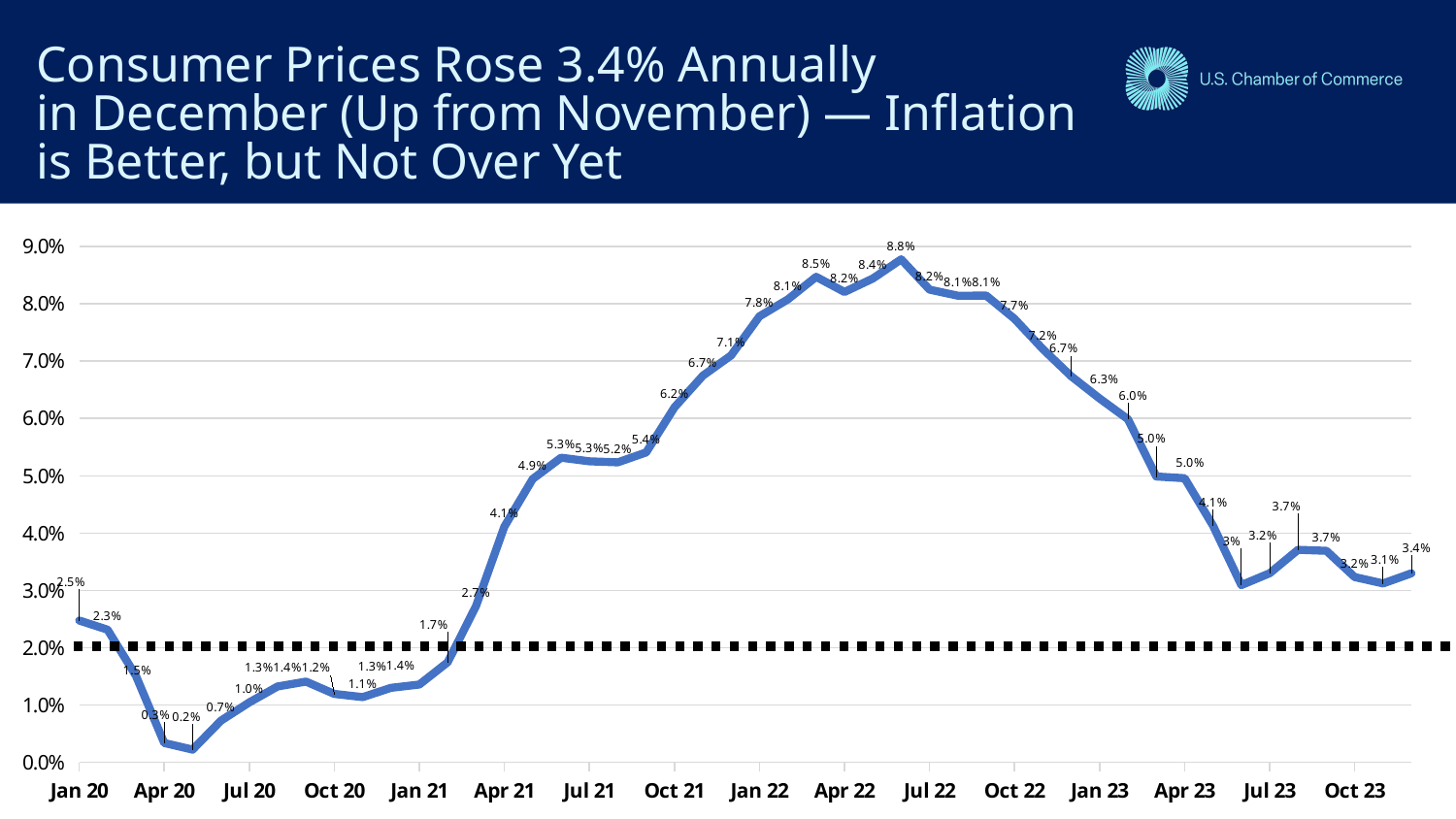
What is the value at Jan 20? 2.5% At what level is the horizontal dashed black line drawn? 2.0% What is the lowest value labeled on the line? 0.2% What is the value at Jan 23? 6.3% Does the line generally rise or fall between Jan 21 and Jul 22? rise Which is larger, the value at Apr 21 or the value at Apr 23? Apr 23 What is the highest value labeled on the line? 8.8% What is the value at Apr 21? 4.1% What is the value at the last point on the line (December 2023)? 3.4% What is the value at Oct 22? 7.7% What is the difference between the value at Jan 22 (7.8%) and the value at Jan 23 (6.3%)? 1.5% What kind of chart is shown on the slide? line chart